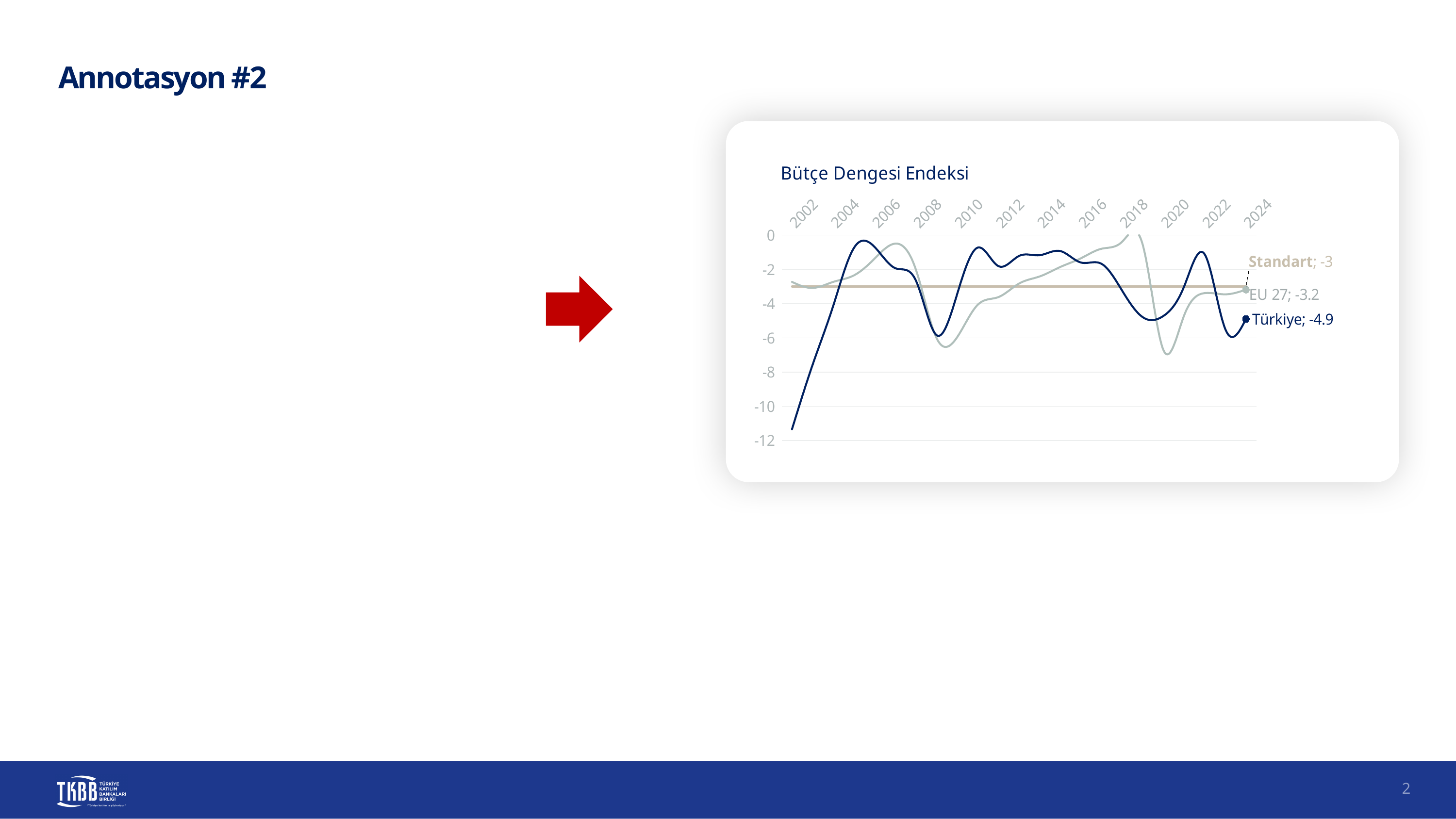
What value is labelled for the Standart line? -3 What is the final labelled value for Türkiye? -4.9 What is the final labelled value for EU 27? -3.2 Which series has the lowest labelled end value? Türkiye How many year labels are shown on the x axis? 12 What kind of chart is shown on the slide? line chart What is the title of the chart? Bütçe Dengesi Endeksi Which series has the highest labelled end value? Standart Is the value for Türkiye in 2002 greater or less than -10? less How many series are plotted in the chart? 3 What is the difference between the labelled end values of EU 27 and Türkiye? 1.7 At the end of the series, which is higher, EU 27 or Türkiye? EU 27